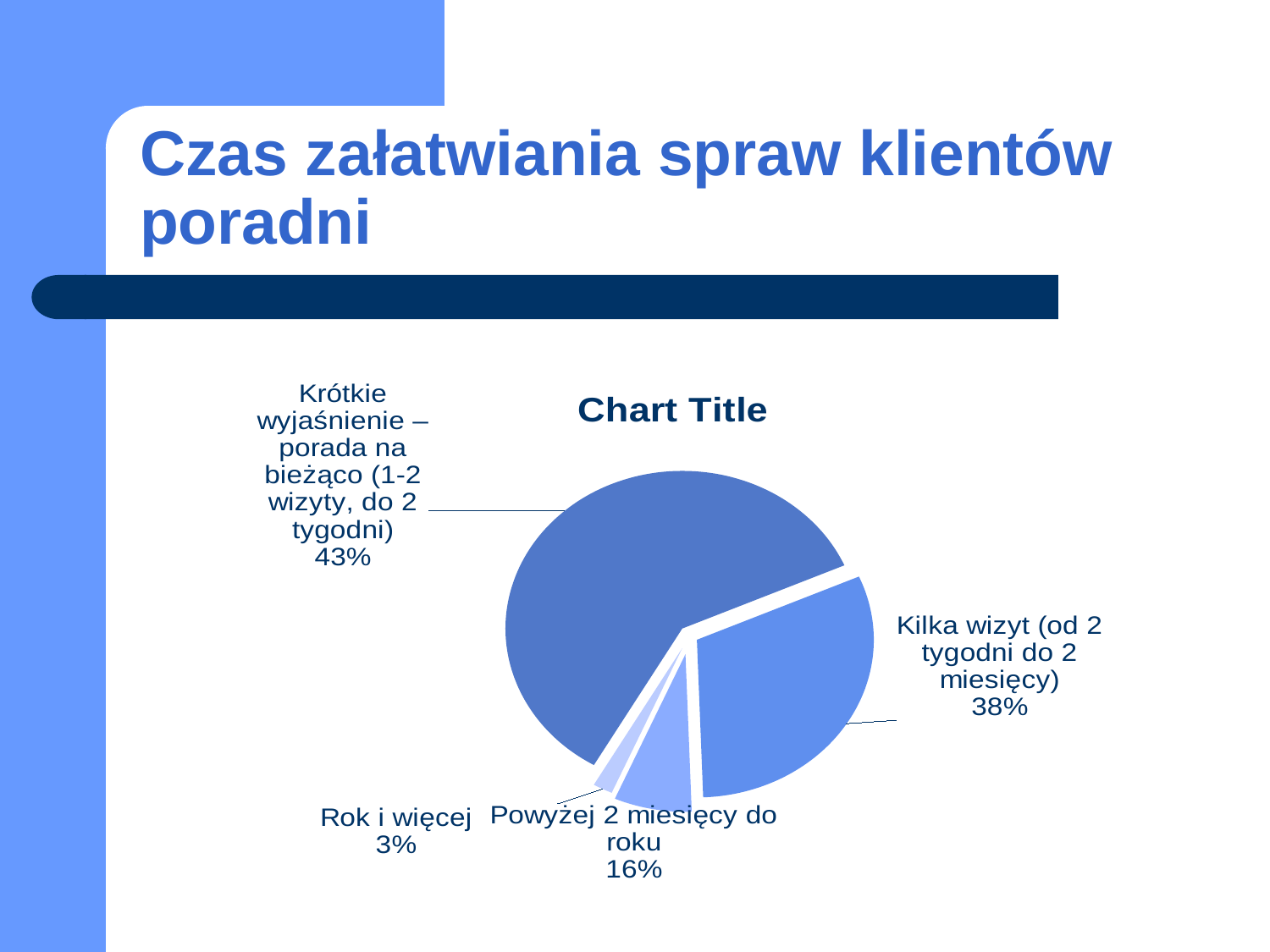
How many slices does the pie chart have? 4 What share of the pie is labelled "Kilka wizyt (od 2 tygodni do 2 miesięcy)"? 38% What title is printed above the pie chart? Chart Title Which category has the largest slice of the pie? Krótkie wyjaśnienie – porada na bieżąco (1-2 wizyty, do 2 tygodni) What is the combined share of "Powyżej 2 miesięcy do roku" and "Rok i więcej"? 19% What percentage is shown for "Rok i więcej"? 3% What percentage is shown for "Krótkie wyjaśnienie – porada na bieżąco (1-2 wizyty, do 2 tygodni)"? 43% Which is larger: the share for "Powyżej 2 miesięcy do roku" or the share for "Rok i więcej"? Powyżej 2 miesięcy do roku Which category has the smallest slice of the pie? Rok i więcej What type of chart is shown on the slide? Pie chart What percentage is shown for "Powyżej 2 miesięcy do roku"? 16% What is the difference in percentage points between "Krótkie wyjaśnienie – porada na bieżąco" and "Kilka wizyt (od 2 tygodni do 2 miesięcy)"? 5 percentage points